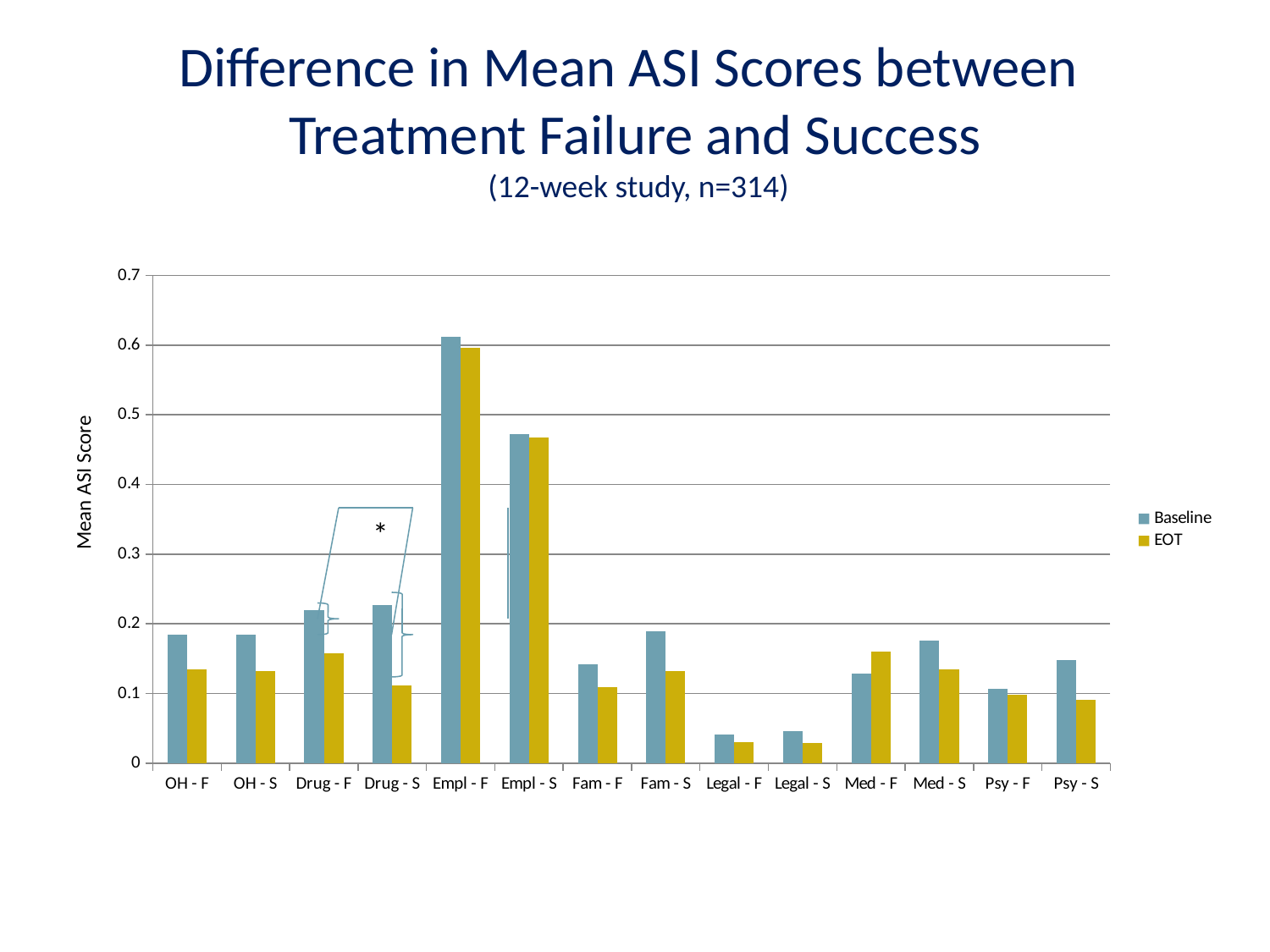
Is the EOT value for Med - F greater or less than 0.1? greater How many categories are shown on the x axis? 14 What is the title of the y axis? Mean ASI Score Which category has the highest Baseline value? Empl - F What kind of chart is shown on the slide? bar chart Is the Baseline value for Drug - S greater or less than 0.2? greater Is the Baseline value for Empl - S greater or less than 0.4? greater Which category has the highest EOT value? Empl - F For Drug - S, which is larger: the Baseline value or the EOT value? Baseline How many series does the legend list? 2 For Med - F, which is larger: the Baseline value or the EOT value? EOT